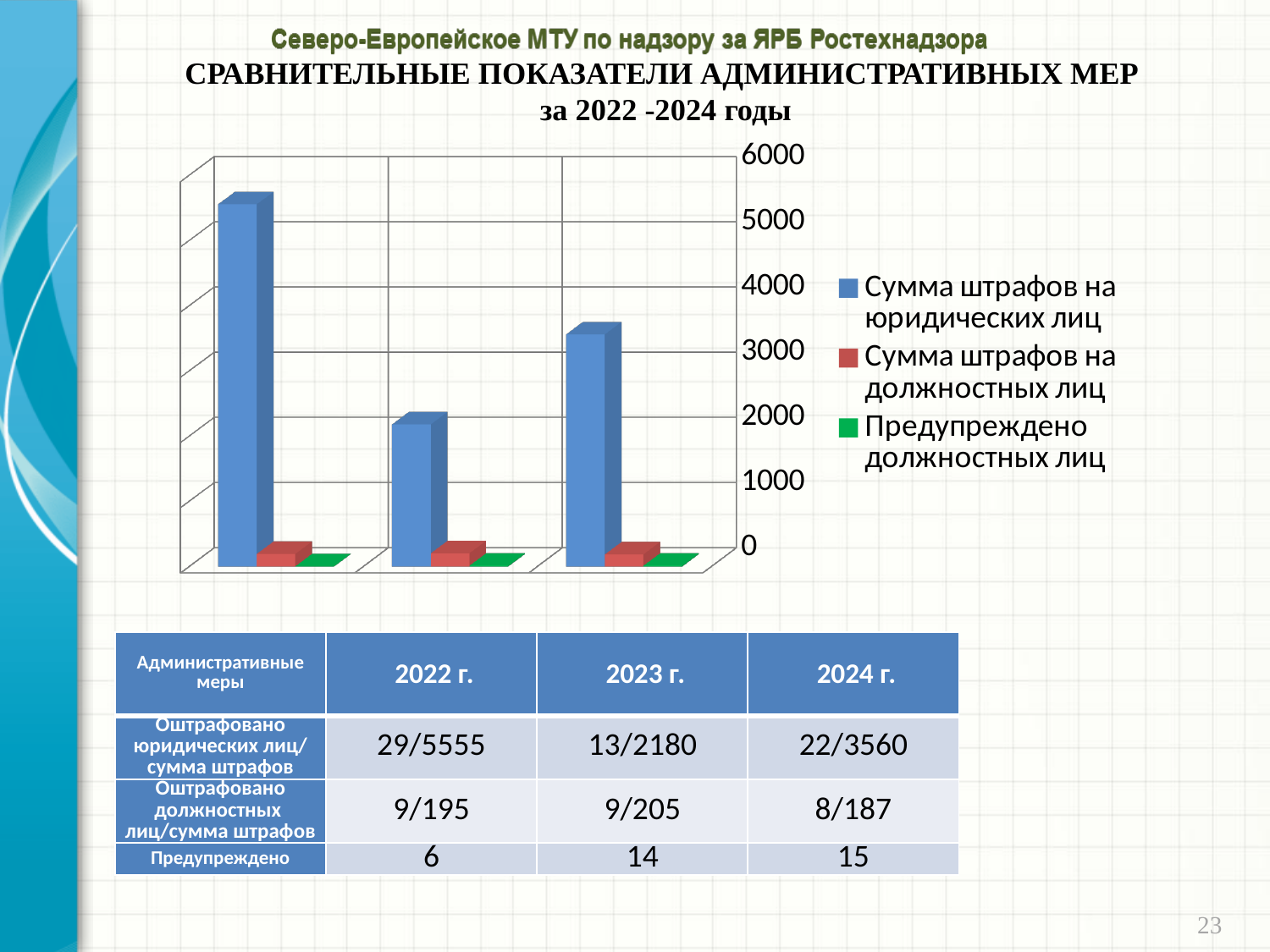
Is the blue bar in the leftmost group greater or less than 5000? greater Are the red bars (Сумма штрафов на должностных лиц) greater or less than 1000 in every group? less Does the blue series rise or fall from the first group to the second group? fall How many series does the chart legend list? 3 How many groups of bars are plotted in the chart? 3 Which group of bars has the shortest blue bar (Сумма штрафов на юридических лиц)? the middle (second) group Is the blue bar in the middle group greater or less than 3000? less Which group of bars has the tallest blue bar (Сумма штрафов на юридических лиц)? the leftmost (first) group Which is larger: the blue bar in the rightmost group or the blue bar in the middle group? the rightmost group What kind of chart is shown on the slide? bar chart What colour represents the series 'Предупреждено должностных лиц' in the legend? green